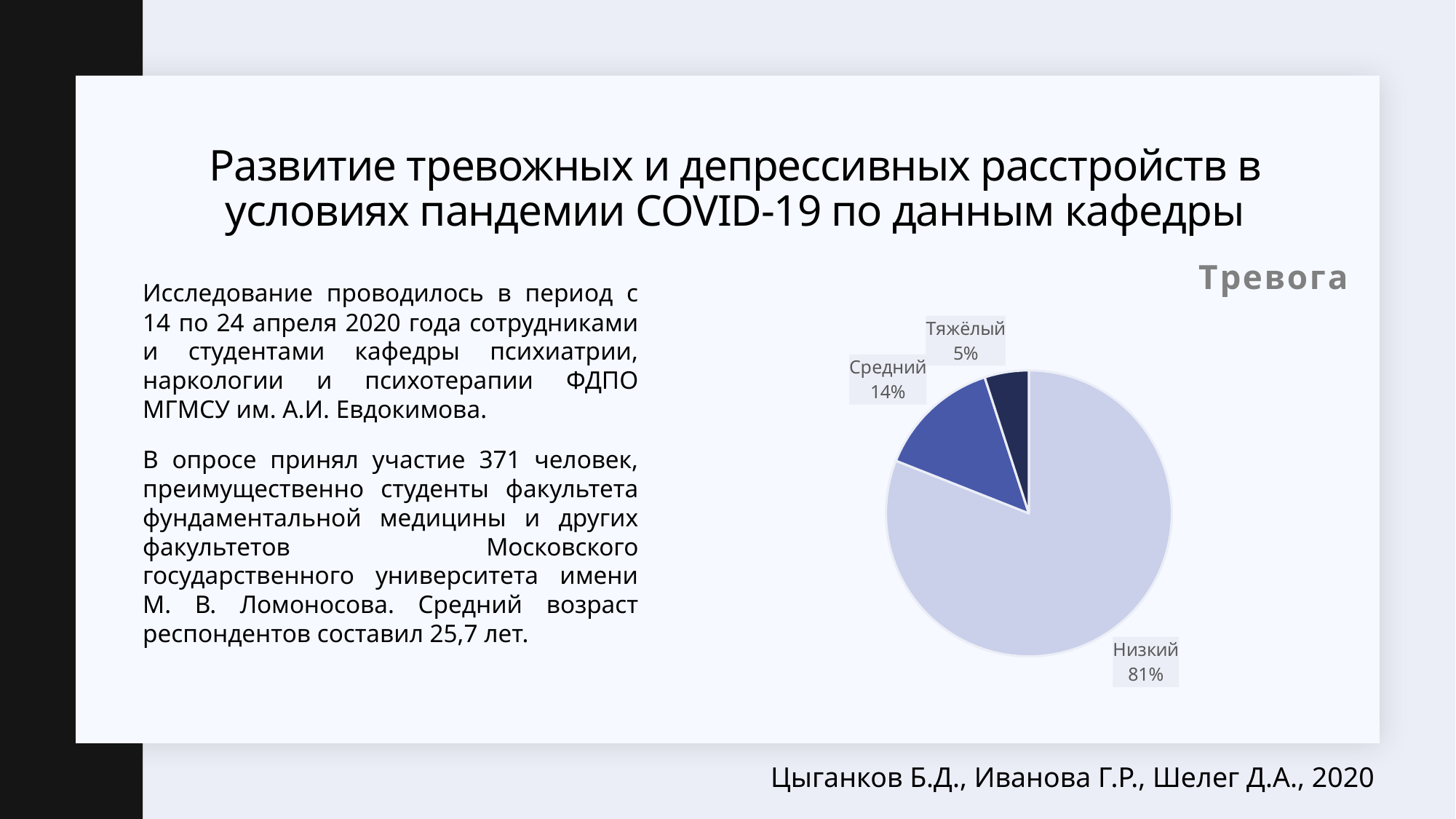
What type of chart is shown on the slide? pie chart What is the title of the chart? Тревога What is the value shown for 'Средний'? 14% What is the difference between the 'Средний' and 'Тяжёлый' shares? 9% Which is larger, the 'Средний' slice or the 'Тяжёлый' slice? Средний What share of the pie does the 'Низкий' slice represent? 81% What is the difference between the 'Низкий' and 'Средний' shares? 67% Which category has the smallest slice of the pie? Тяжёлый Is the share for 'Низкий' greater or less than 50%? greater Which category has the largest slice of the pie? Низкий What is the value shown for 'Тяжёлый'? 5% How many slices does the pie chart have? 3